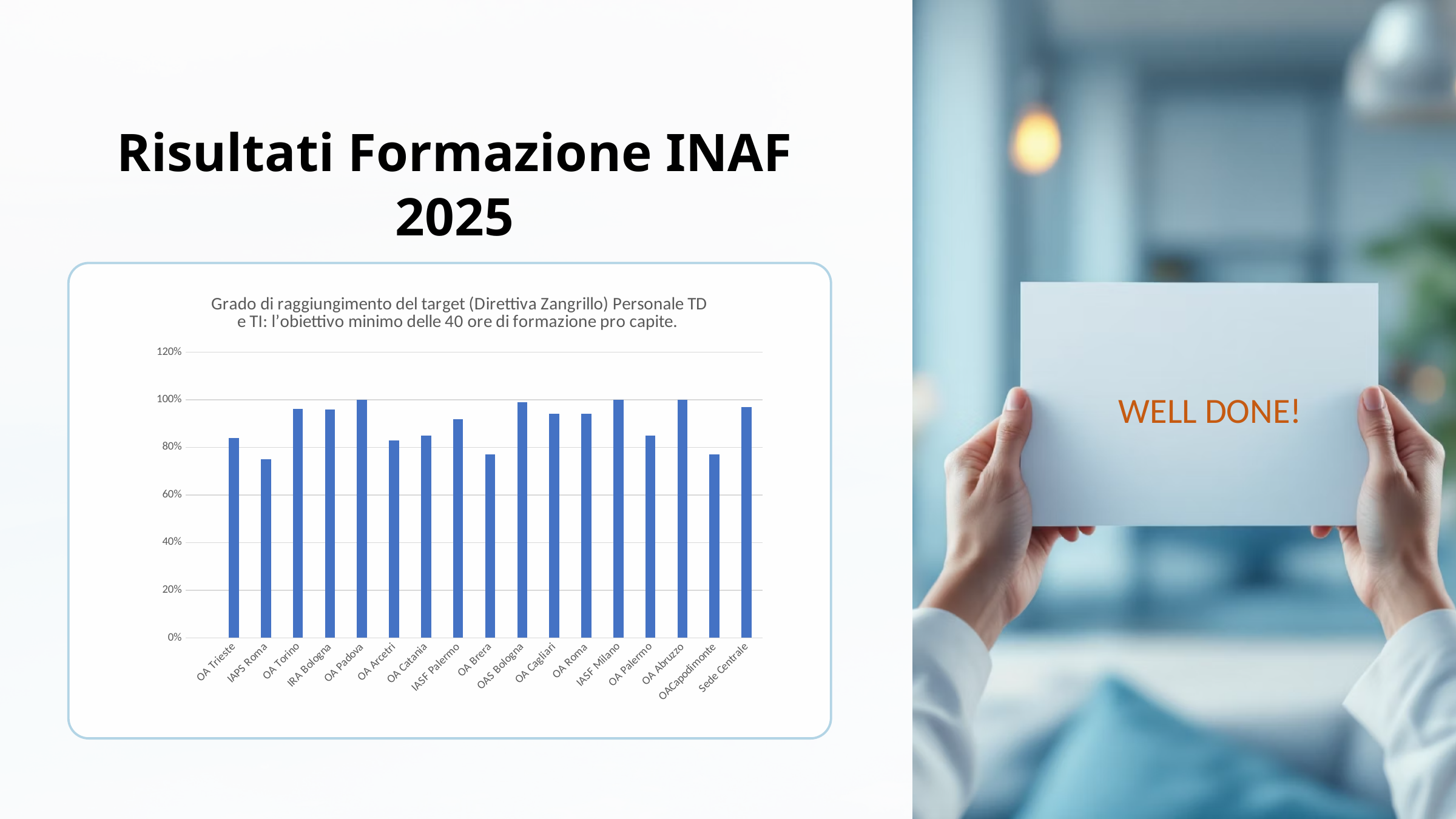
What is the value for OA Padova? 100% Is the value for IAPS Roma greater or less than 80%? less Which has the larger value, OA Torino or IAPS Roma? OA Torino What colour are the bars in the chart? blue What kind of chart is shown on the slide? bar chart Is the value for Sede Centrale greater or less than 80%? greater Which has the larger value, IASF Milano or OA Brera? IASF Milano Which has the larger value, OA Trieste or OA Torino? OA Torino Is the value for OACapodimonte greater or less than 80%? less How many categories (institutes) are shown on the x axis of the chart? 17